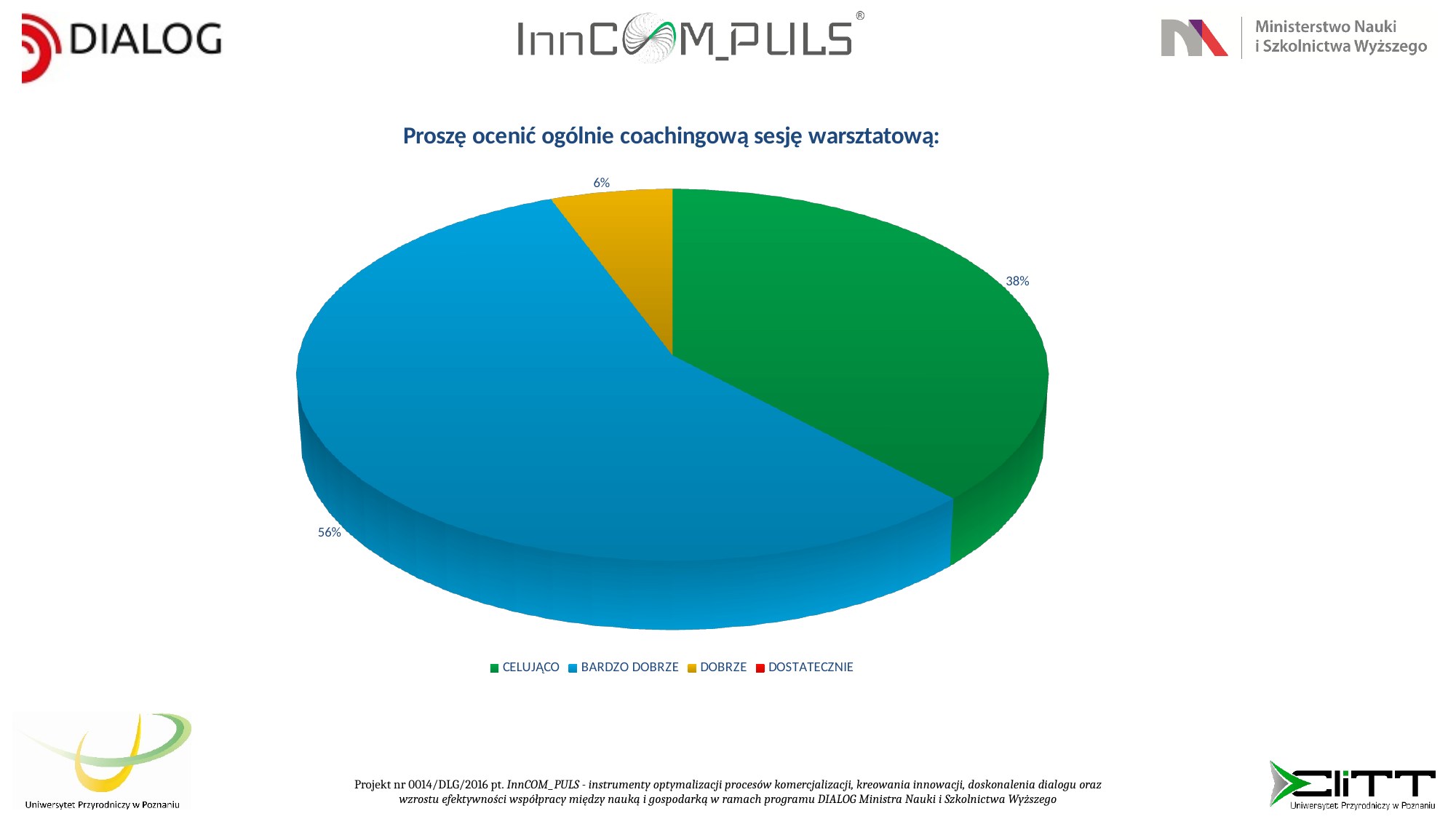
What percentage of the pie is labelled for DOBRZE? 6% By how many percentage points does BARDZO DOBRZE exceed CELUJĄCO? 18 Which category has the largest slice of the pie? BARDZO DOBRZE What colour represents DOBRZE in the legend? yellow Which of the labelled slices is the smallest? DOBRZE Which is larger, the slice for CELUJĄCO or the slice for BARDZO DOBRZE? BARDZO DOBRZE What kind of chart is shown on the slide? pie chart How many categories does the legend list? 4 What is the combined share of CELUJĄCO and DOBRZE? 44% What percentage of the pie is labelled for BARDZO DOBRZE? 56% What is the title of the chart? Proszę ocenić ogólnie coachingową sesję warsztatową: What percentage of the pie is labelled for CELUJĄCO? 38%